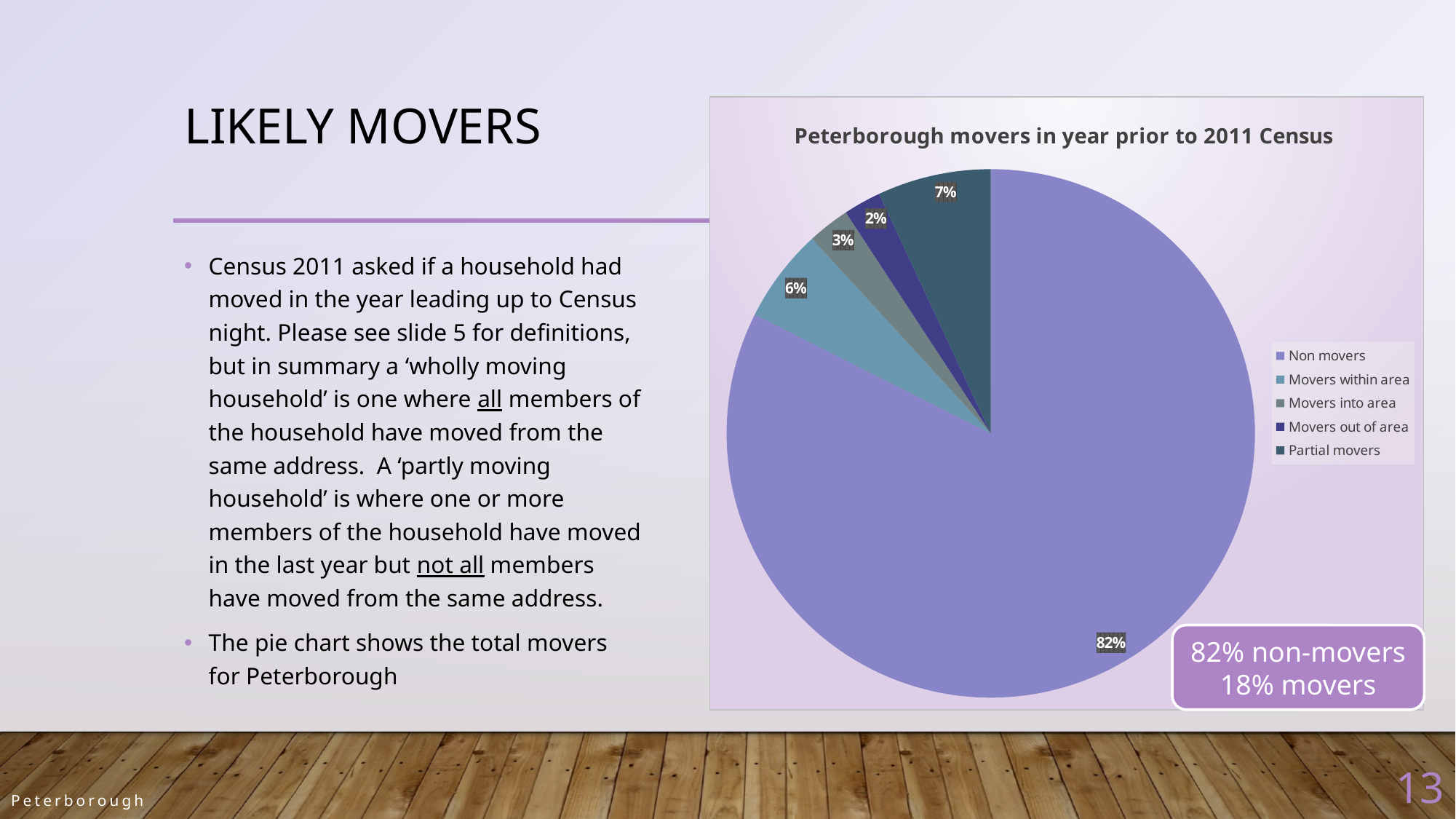
What share of the pie is labelled for Non movers? 82% What is the title of the chart? Peterborough movers in year prior to 2011 Census What share of the pie is labelled for Movers into area? 3% What is the difference in percentage points between Movers within area and Movers into area? 3% Which category has the smallest slice of the pie? Movers out of area How many categories does the legend list? 5 What share of the pie is labelled for Movers out of area? 2% Which is larger, the share for Partial movers or the share for Movers within area? Partial movers Which category has the largest slice of the pie? Non movers What type of chart is shown on the slide? Pie chart